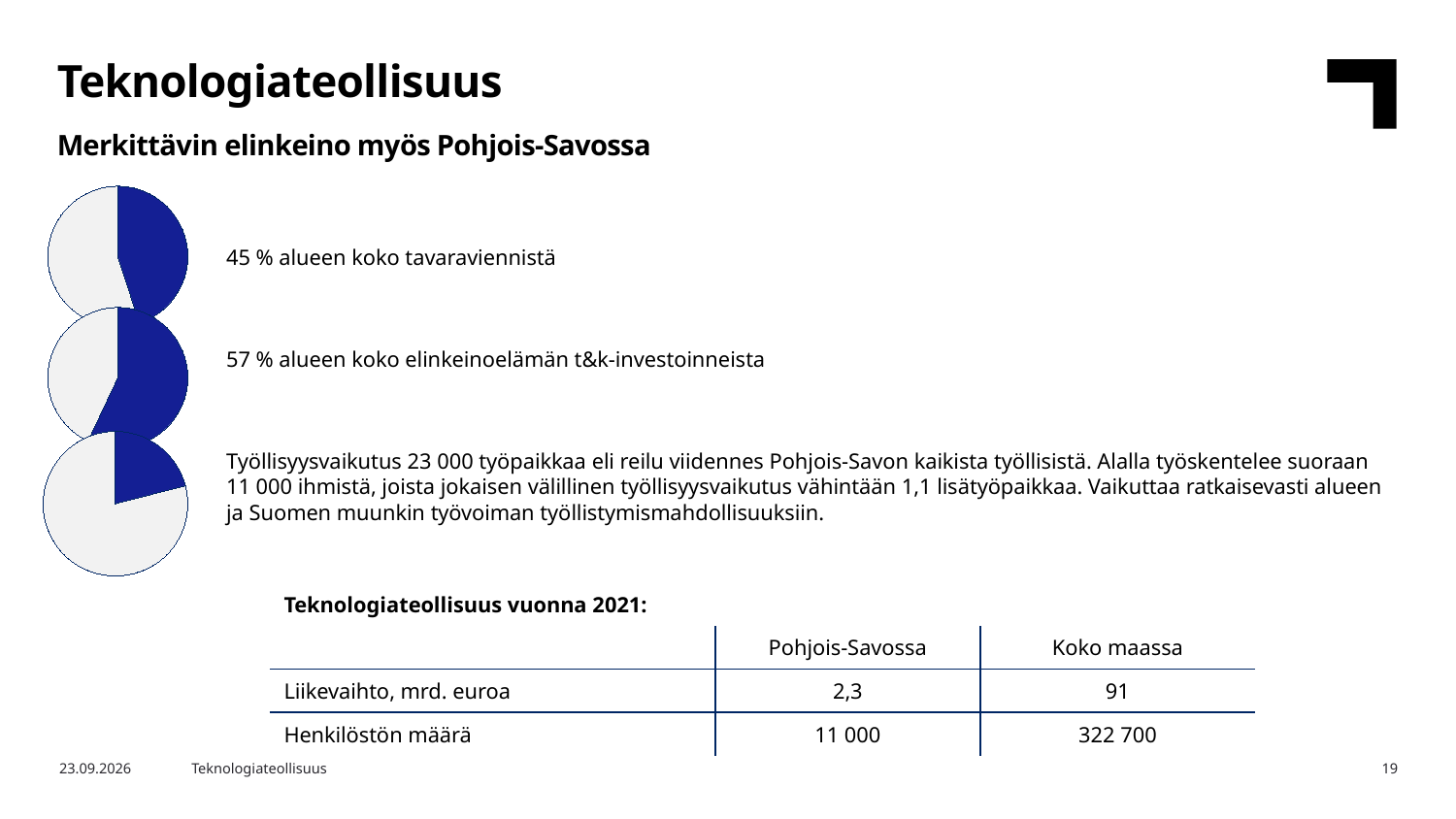
How many pie charts are shown on the slide? 3 Is the blue slice in the top pie chart larger or smaller than the blue slice in the middle pie chart? Smaller What kind of chart are the three charts on the left side of the slide? Pie charts In the top pie chart on the left, what share of the region's total goods exports does the blue slice represent, according to the text beside it? 45 % What is the difference in percentage points between the shares shown for the middle pie chart (57 %) and the top pie chart (45 %)? 12 percentage points Is the blue slice in the middle pie chart on the left greater or less than 50% of the pie? greater How many slices does each pie chart on the left have? 2 What two colours are used for the slices in the pie charts on the left? Blue and light grey Which of the three pie charts on the left has the largest blue slice? The middle pie chart In the middle pie chart on the left, what share of the region's business R&D investments does the blue slice represent, according to the text beside it? 57 % Is the blue slice in the bottom pie chart on the left greater or less than 50% of the pie? less Which of the three pie charts on the left has the smallest blue slice? The bottom pie chart